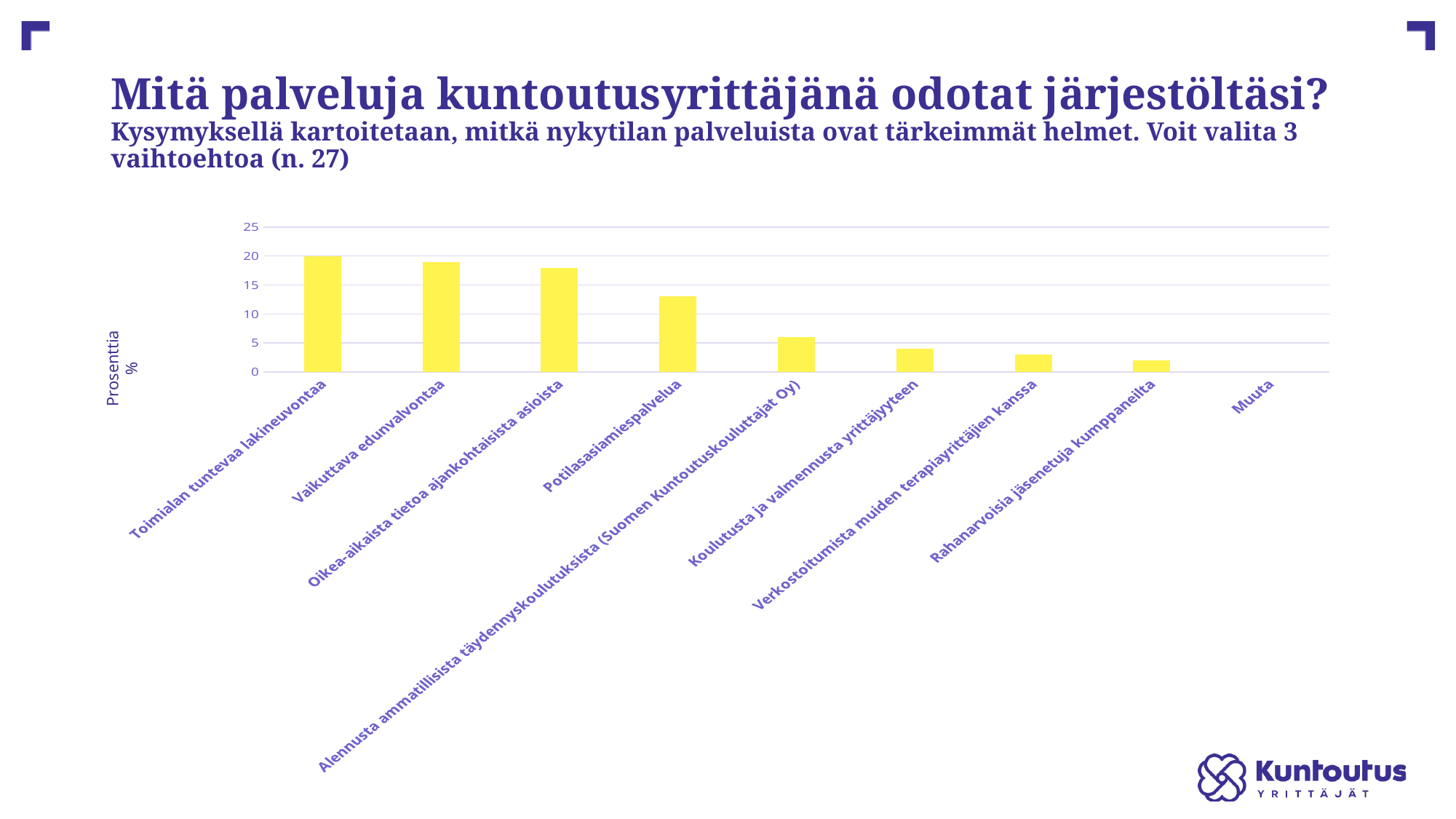
Which is larger, the value for Potilasasiamiespalvelua or the value for Verkostoitumista muiden terapiayrittäjien kanssa? Potilasasiamiespalvelua What kind of chart is shown on the slide? bar chart Is the value for Oikea-aikaista tietoa ajankohtaisista asioista greater or less than 15? greater Is the value for Rahanarvoisia jäsenetuja kumppaneilta greater or less than 5? less Is the value for Koulutusta ja valmennusta yrittäjyyteen greater or less than 5? less How many categories are shown on the x axis of the chart? 9 What is the label on the vertical axis of the chart? Prosenttia % Do the values rise or fall from left to right along the x axis? fall Which category has the highest value in the chart? Toimialan tuntevaa lakineuvontaa What is the value for Muuta? 0 Which category has the lowest value in the chart? Muuta